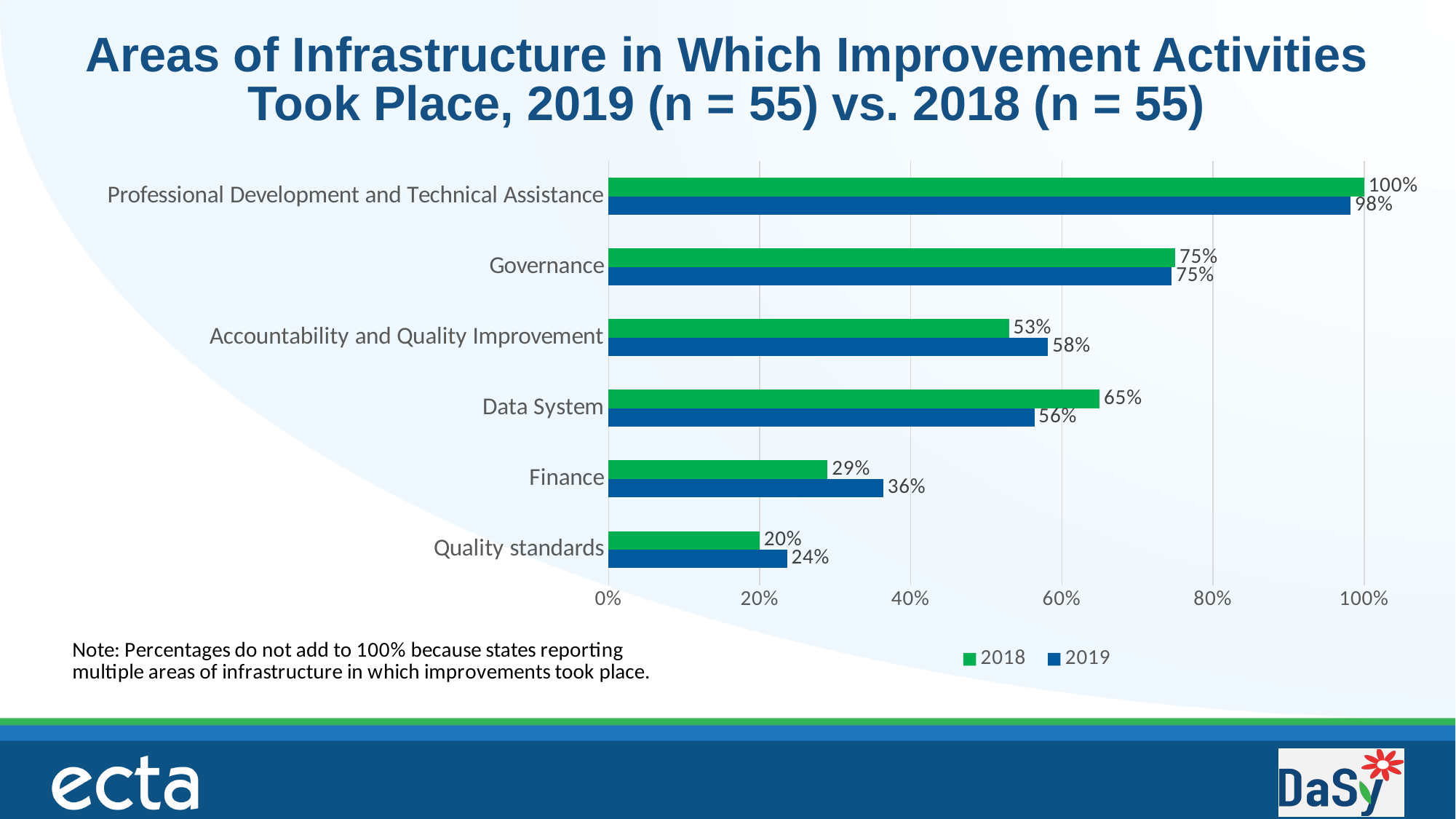
Which category has the lowest 2019 value? Quality standards What is the difference between the 2019 and 2018 values for Finance? 7% What is the 2019 value for Professional Development and Technical Assistance? 98% Is the 2019 value for Governance greater or less than 60%? greater What is the difference between the 2018 and 2019 values for Data System? 9% What is the 2018 value for Data System? 65% How many series does the legend list? 2 What kind of chart is shown on the slide? bar chart What is the 2019 value for Finance? 36% How many categories are shown on the chart? 6 Which is larger for Accountability and Quality Improvement, the 2018 value or the 2019 value? 2019 Which category has the highest 2018 value? Professional Development and Technical Assistance